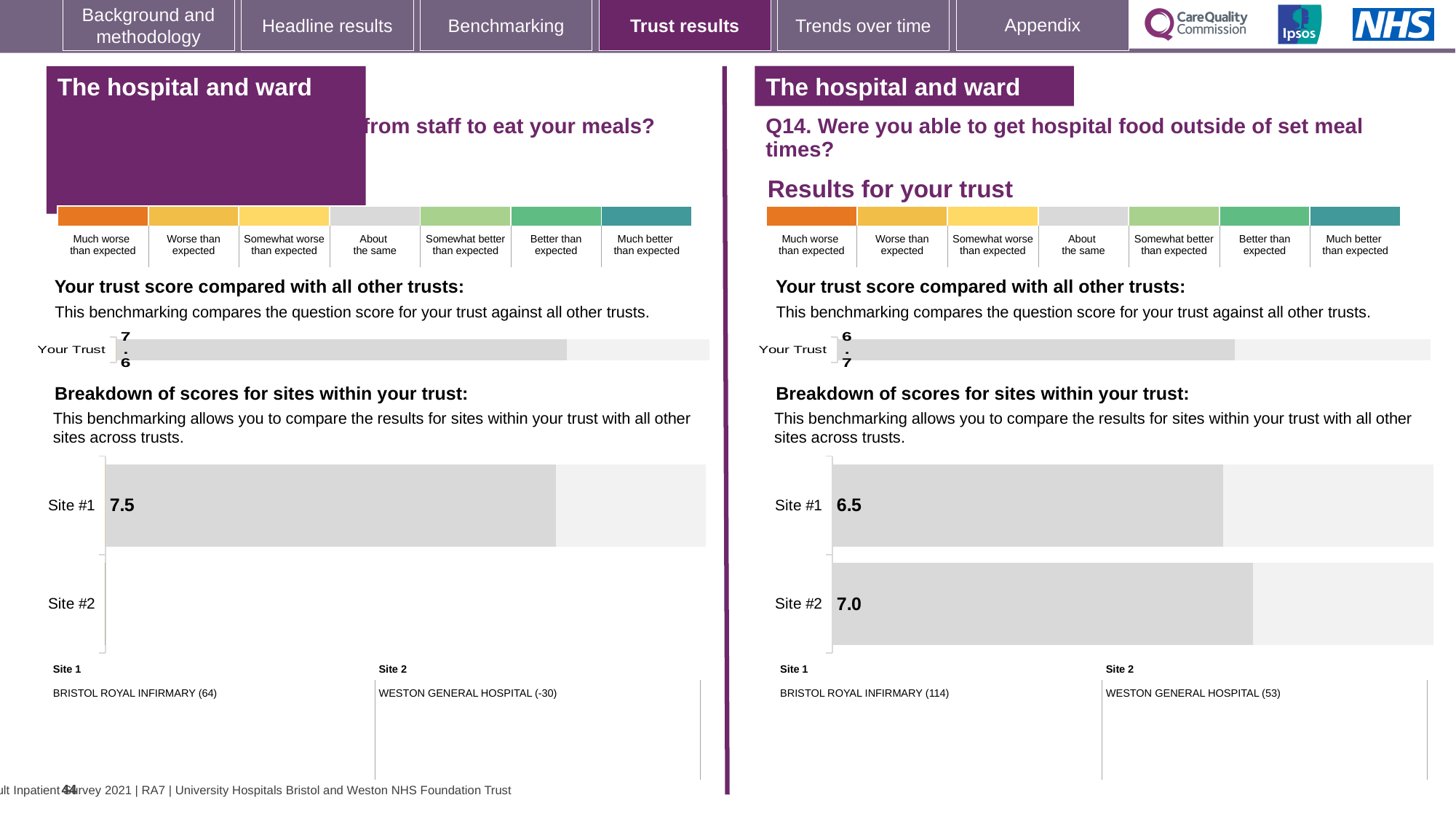
On the right-hand chart for Q14 (hospital food outside of set meal times), what is the score for Site #2? 7.0 On the right-hand site breakdown chart for Q14, how many sites are plotted? 2 According to the key below the right-hand site breakdown chart, which hospital is Site 2? WESTON GENERAL HOSPITAL (53) On the left-hand site breakdown chart (question ending 'from staff to eat your meals?'), what is the score for Site #1? 7.5 On the left-hand 'Your trust score compared with all other trusts' chart, what is the score for Your Trust? 7.6 On the right-hand chart for Q14, what is the difference between the Site #2 score and the Site #1 score? 0.5 On the right-hand chart for Q14, which site has the higher score, Site #1 or Site #2? Site #2 On the right-hand 'Your trust score compared with all other trusts' chart for Q14, what is the score for Your Trust? 6.7 On the right-hand chart for Q14, which site has the lowest score? Site #1 On the left-hand site breakdown chart, how many sites are listed on the axis? 2 What type of chart is used for the site breakdown on the right-hand side of the slide? Bar chart On the right-hand chart for Q14 (hospital food outside of set meal times), what is the score for Site #1? 6.5